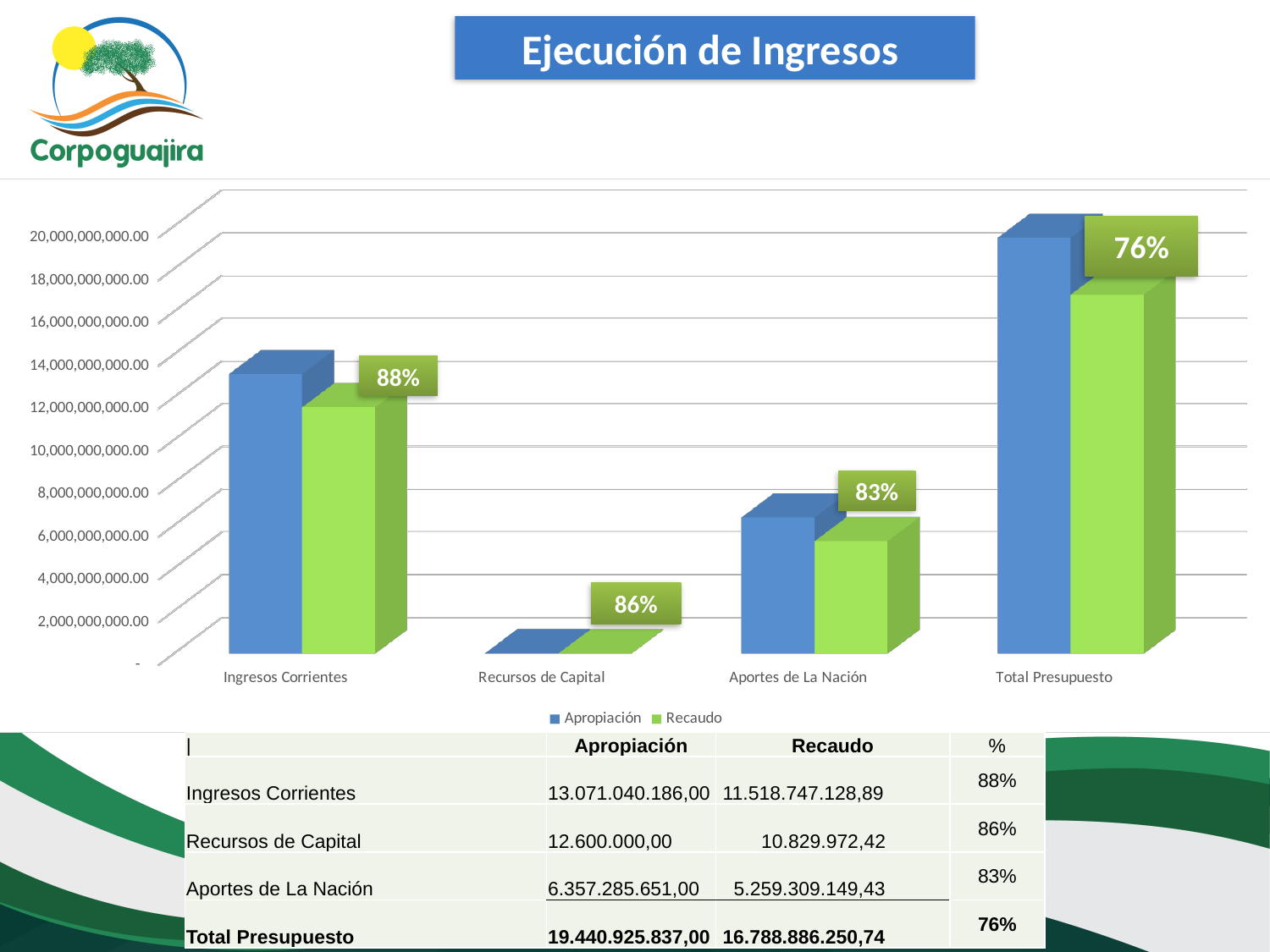
What percentage label is shown for Ingresos Corrientes? 88% What kind of chart is shown on the slide? Bar chart What percentage label is shown for Total Presupuesto? 76% What is the title shown above the chart? Ejecución de Ingresos Which category has the highest percentage label on the chart? Ingresos Corrientes Is the Recaudo value for Total Presupuesto greater or less than 16,000,000,000.00? greater How many categories are shown on the x axis of the chart? 4 Which is larger for Ingresos Corrientes, the Apropiación bar or the Recaudo bar? Apropiación Is the Apropiación value for Aportes de La Nación greater or less than 8,000,000,000.00? less What is the difference between the percentage labels for Ingresos Corrientes and Aportes de La Nación? 5% Which category has the lowest percentage label on the chart? Total Presupuesto How many series does the chart legend list? 2